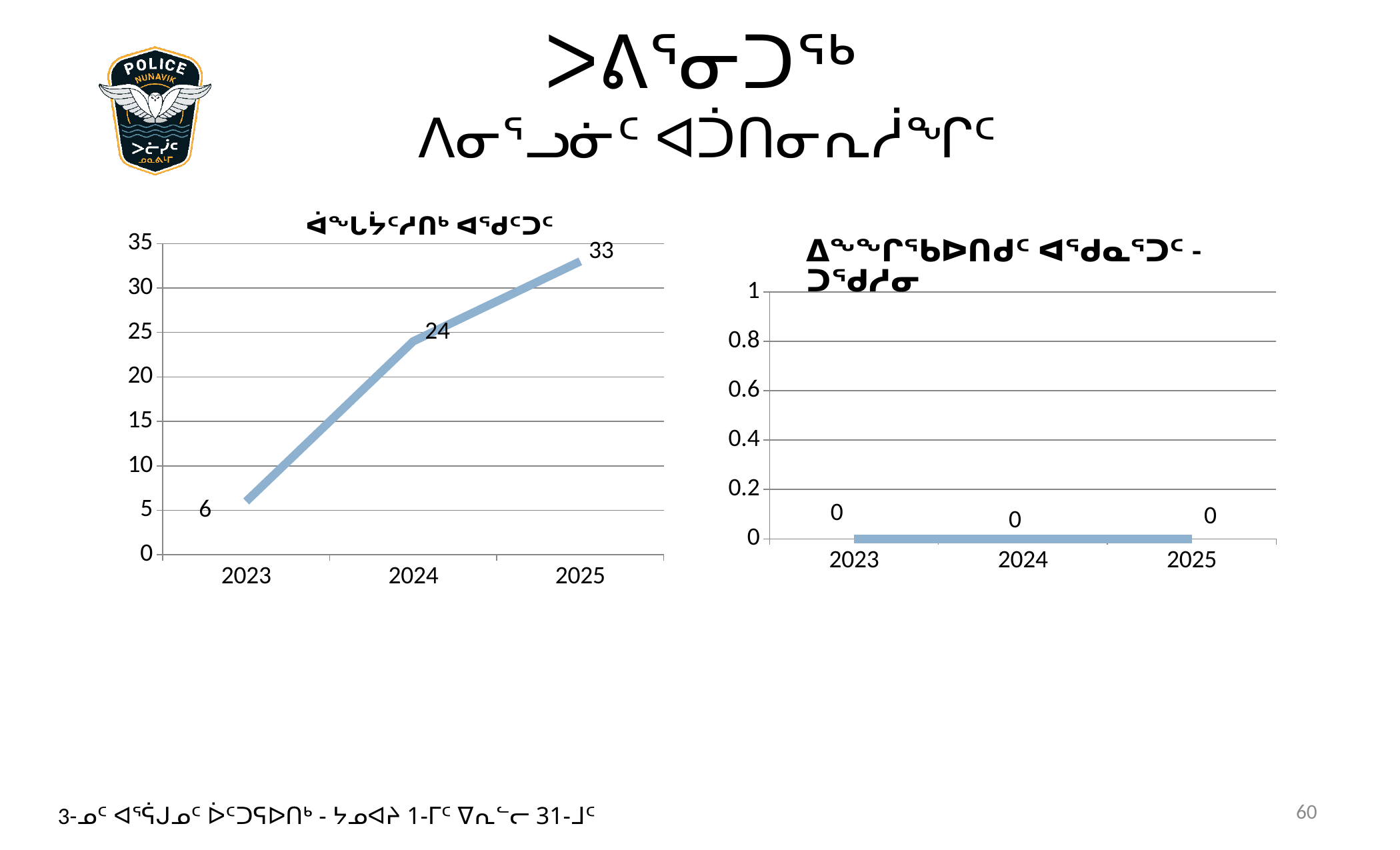
In the left chart, what is the difference between the values for 2024 and 2023? 18 What kind of chart is the left chart? line chart In the left chart, what is the value for 2023? 6 In the left chart, what is the value for 2025? 33 How many years are plotted on the x axis of the left chart? 3 In the left chart, which is larger, the value for 2024 or the value for 2025? 2025 In the right chart, what is the value for 2024? 0 In the left chart, which year has the highest value? 2025 In the left chart, what is the value for 2024? 24 In the left chart, do the values rise or fall from 2023 to 2025? rise In the left chart, which year has the lowest value? 2023 In the left chart, what is the difference between the values for 2025 and 2023? 27